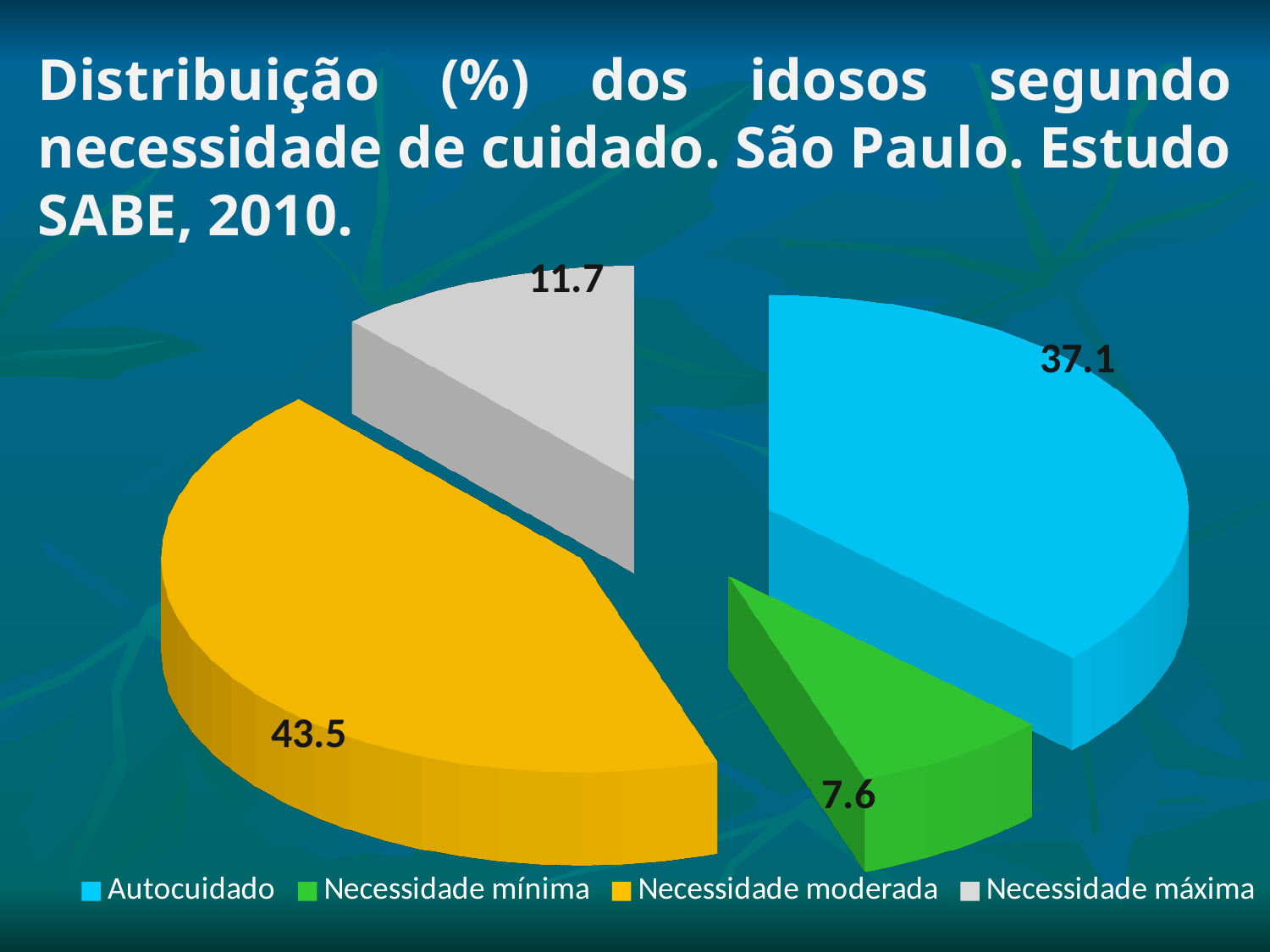
What is the value for Necessidade máxima? 11.7 How many slices does the pie chart have? 4 What kind of chart is shown on the slide? pie chart Which is larger, the value for Autocuidado or the value for Necessidade máxima? Autocuidado Which colour represents Necessidade mínima in the legend? green What is the value for Autocuidado? 37.1 Which category has the largest slice? Necessidade moderada What is the value for Necessidade mínima? 7.6 What is the value for Necessidade moderada? 43.5 What is the difference between the values for Necessidade moderada and Autocuidado? 6.4 Which category has the smallest slice? Necessidade mínima What is the difference between the values for Necessidade máxima and Necessidade mínima? 4.1